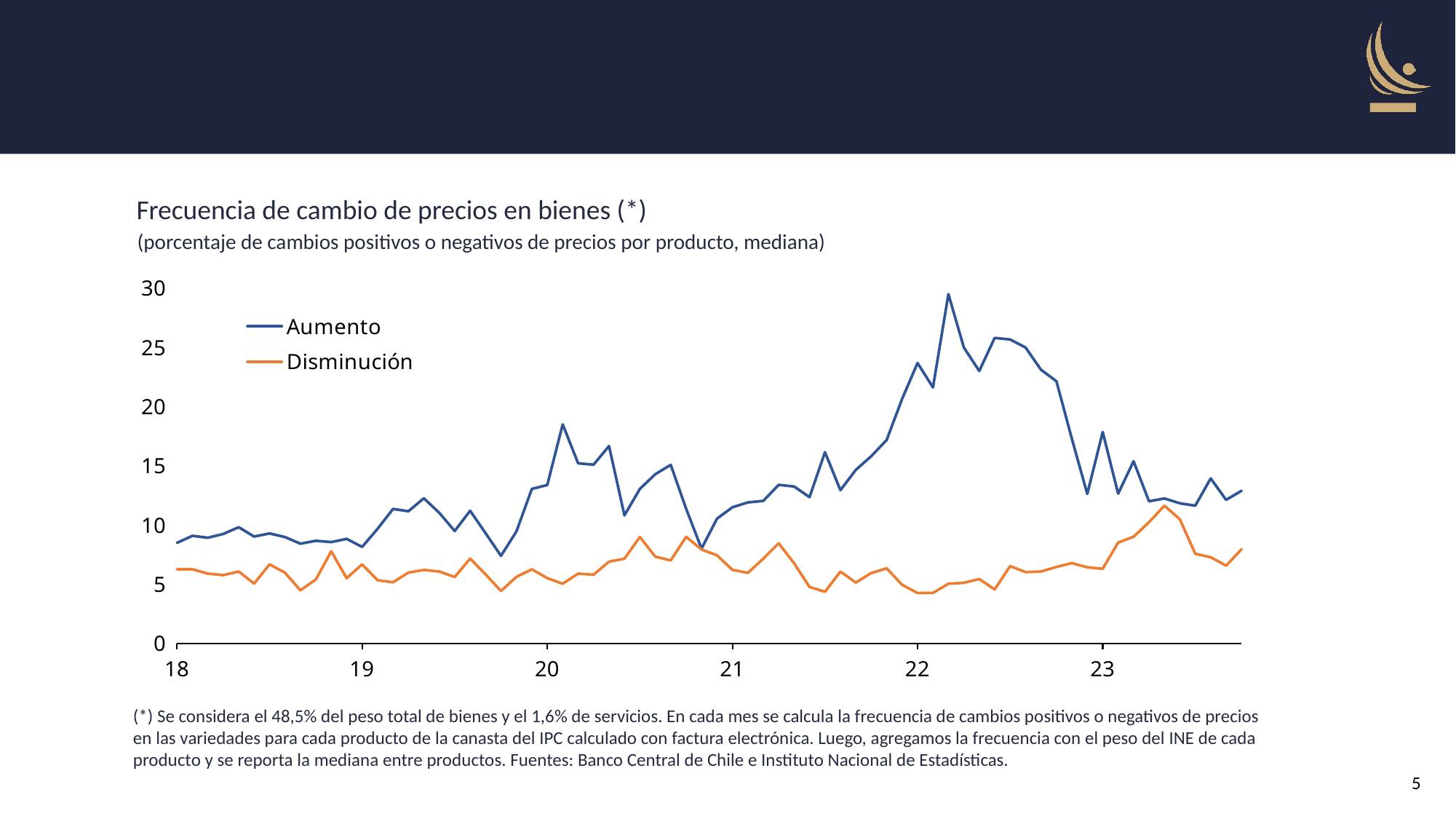
Between 22 and 23 on the x axis, does the Aumento series rise or fall overall? fall Is the highest value reached by the Aumento series greater or less than 25? greater Does the Disminución series ever exceed 15? no Is the value of Aumento at 18 greater or less than 10? less What are the two series named in the legend? Aumento and Disminución How many year labels are shown on the x axis? 6 What is the title of the chart? Frecuencia de cambio de precios en bienes (*) At 22 on the x axis, which series has the higher value, Aumento or Disminución? Aumento How many series does the legend list? 2 What kind of chart is shown on the slide? line chart Which series reaches a higher peak, Aumento or Disminución? Aumento